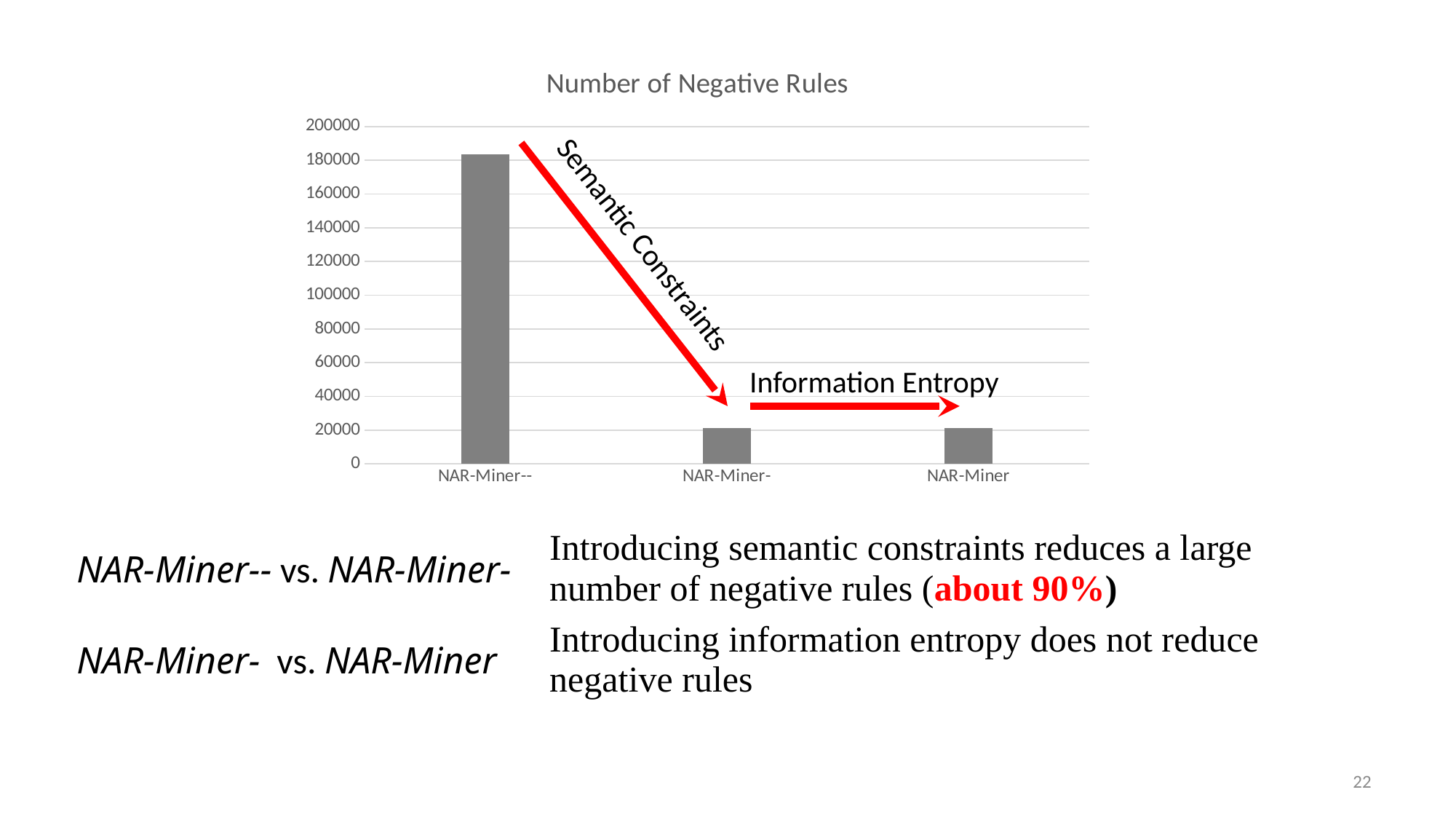
Does the value rise or fall from NAR-Miner-- to NAR-Miner-? fall Which has a larger value, NAR-Miner-- or NAR-Miner-? NAR-Miner-- What kind of chart is shown on the slide? bar chart Which has a larger value, NAR-Miner-- or NAR-Miner? NAR-Miner-- Is the value for NAR-Miner-- greater or less than 100000? greater Is the value for NAR-Miner greater or less than 40000? less What is the title of the chart? Number of Negative Rules Is the value for NAR-Miner-- greater or less than 160000? greater What is the highest tick value shown on the y axis of the chart? 200000 How many categories are shown on the x axis of the chart? 3 Which category has the highest number of negative rules? NAR-Miner--